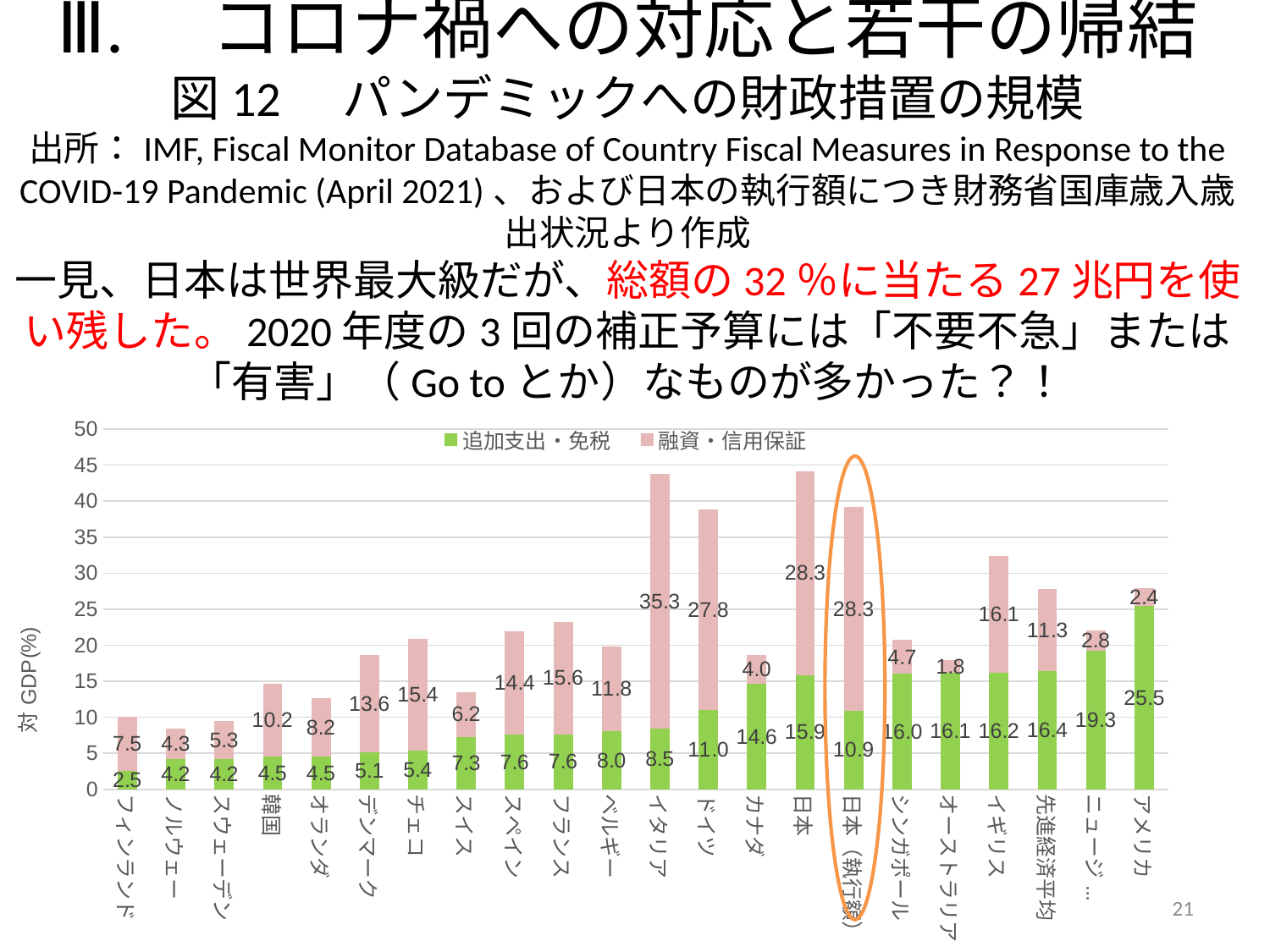
What type of chart is shown on the slide? stacked bar chart What is the 融資・信用保証 value for イタリア? 35.3 How many countries or categories are shown on the x axis? 22 How many series does the legend list? 2 What is the total of the stacked bar for ドイツ? 38.8 What is the label of the y axis? 対 GDP(%) What is the difference between the 追加支出・免税 values for 日本 and 日本（執行額）? 5.0 What is the 追加支出・免税 value for 日本（執行額）? 10.9 Which country has the lowest 融資・信用保証 value? オーストラリア Which is larger, the 融資・信用保証 value for 韓国 or for オランダ? 韓国 Which country has the highest 追加支出・免税 value? アメリカ What is the 追加支出・免税 value for アメリカ? 25.5